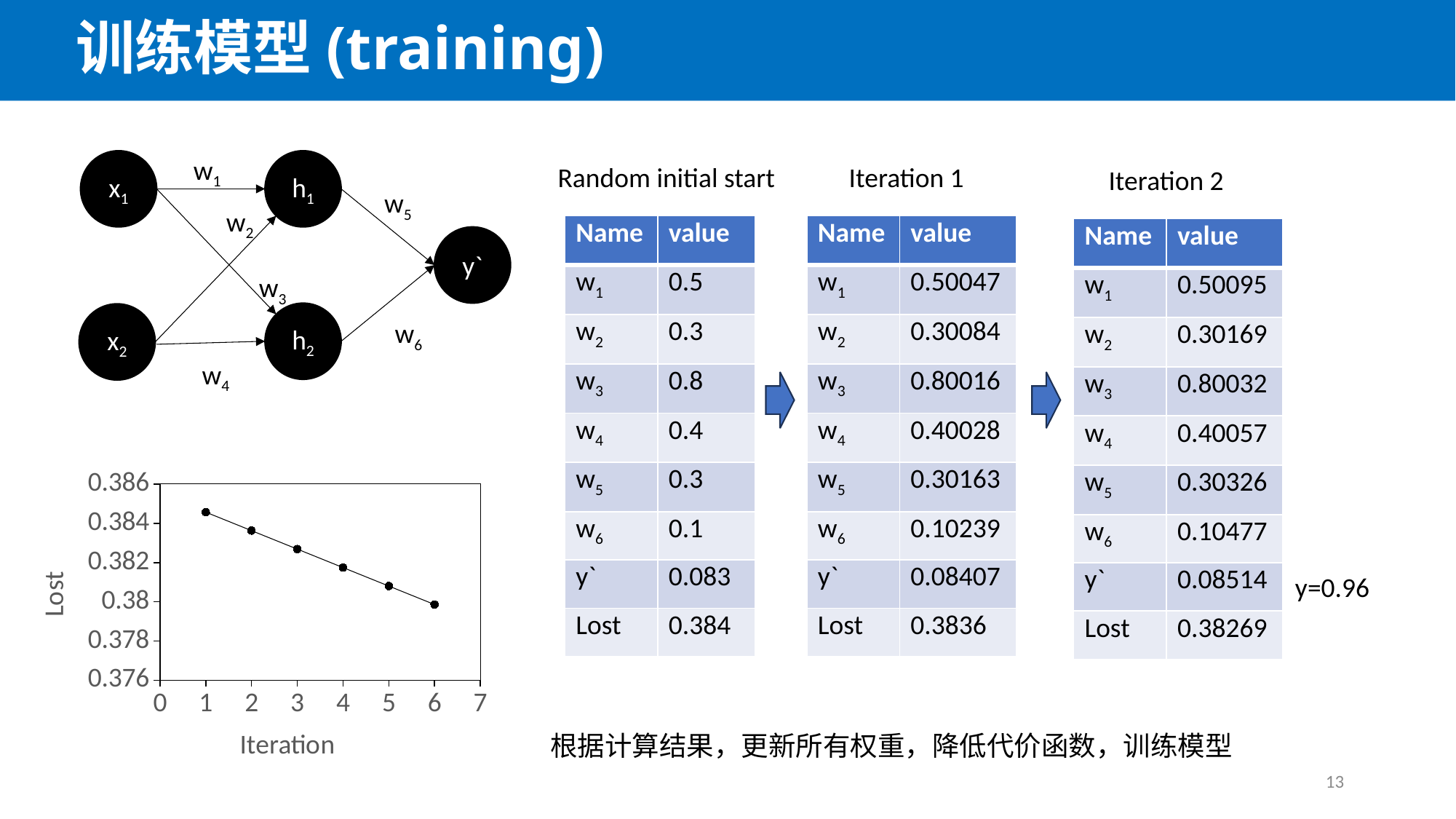
In the Lost vs Iteration chart, at which iteration is the Lost value lowest? 6 In the Lost vs Iteration chart, is the Lost value at iteration 3 greater or less than 0.382? greater In the Lost vs Iteration chart, at which iteration is the Lost value highest? 1 In the Lost vs Iteration chart, is the Lost value at iteration 5 greater or less than 0.38? greater In the Lost vs Iteration chart, which has the larger Lost value, iteration 2 or iteration 5? iteration 2 What is the label of the horizontal axis of the chart on the slide? Iteration What is the label of the vertical axis of the chart on the slide? Lost In the Lost vs Iteration chart, does the Lost value rise or fall as the iteration increases? fall What kind of chart is shown at the bottom left of the slide? line chart How many data points are plotted in the Lost vs Iteration chart? 6